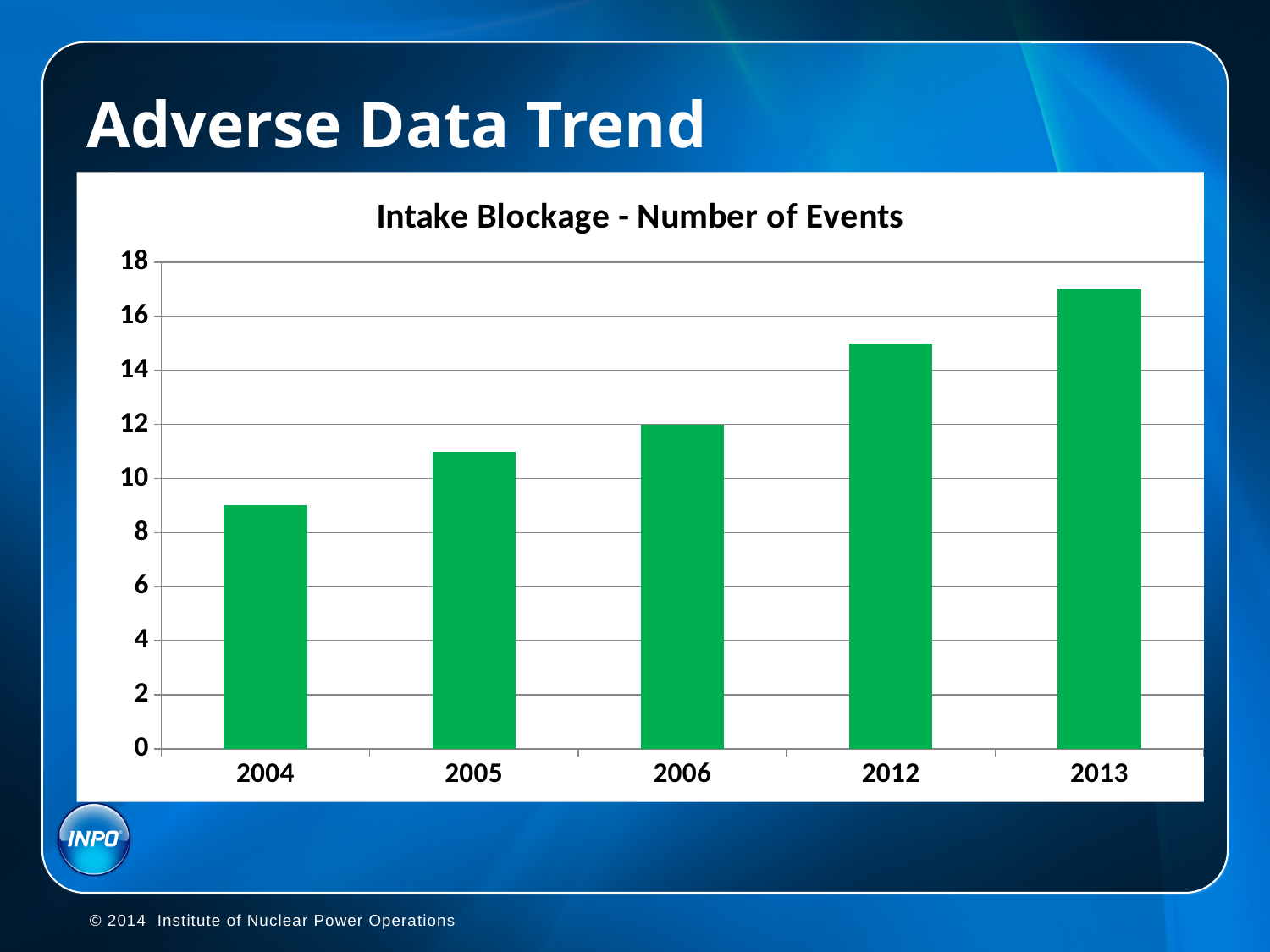
Which year has the lowest number of events? 2004 What is the number of events for 2006? 12 Which year has more events, 2005 or 2012? 2012 Is the value for 2004 greater or less than 10? less What type of chart is shown on the slide? Bar chart Which year has the highest number of events? 2013 How many years are shown on the x axis of the chart? 5 Is the value for 2013 greater or less than 18? less Is the value for 2012 greater or less than 14? greater Do the values rise or fall from 2004 to 2013? rise What is the title of the chart? Intake Blockage - Number of Events